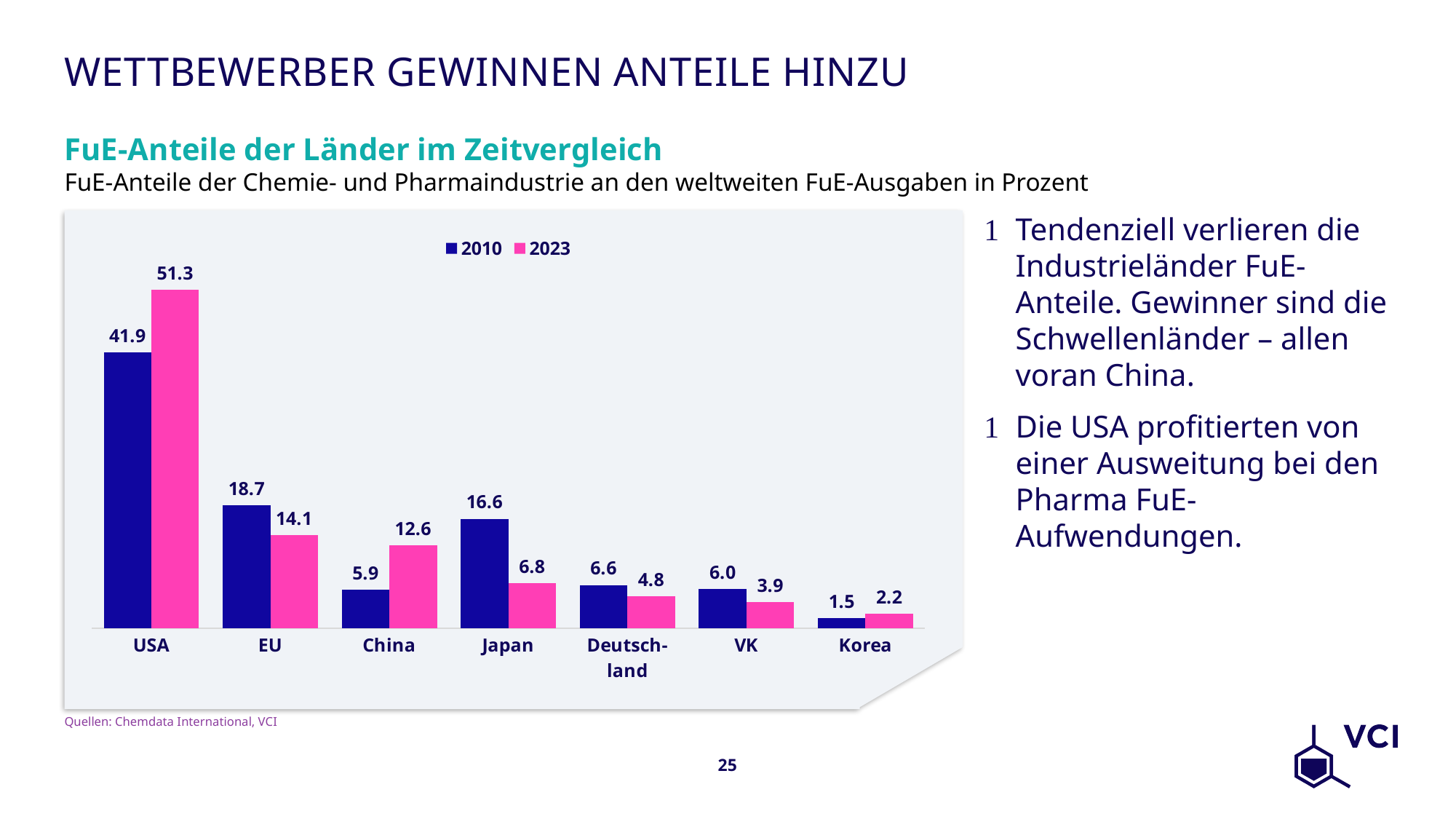
How many countries or regions are shown on the x axis? 7 What is the difference between China's 2023 and 2010 values? 6.7 What is the difference between the EU's 2010 and 2023 values? 4.6 Which country has the highest value in 2010? USA Which country has the lowest value in 2023? Korea What kind of chart is shown on the slide? Bar chart What is the value for China in 2010? 5.9 How many series does the legend list? 2 Which years are listed in the chart legend? 2010 and 2023 Which is larger: Japan's 2023 value or China's 2023 value? China's 2023 value What is the value for the USA in 2023? 51.3 What is the value for Deutschland in 2023? 4.8